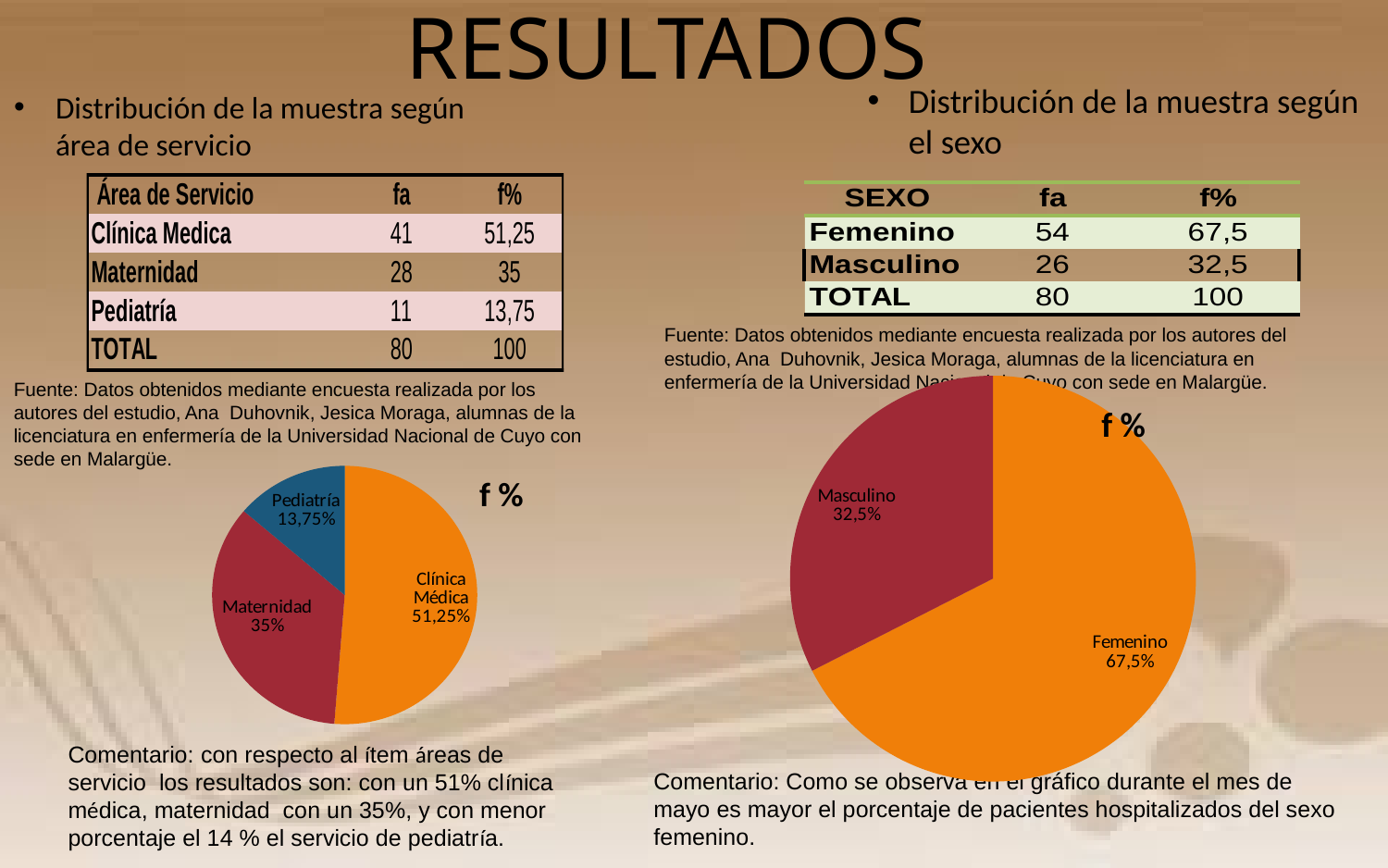
On the left pie chart, which category has the largest slice? Clínica Médica What type of chart is the right chart? Pie chart On the left pie chart, what is the value for Pediatría? 13,75% On the left pie chart, how many slices are there? 3 On the left pie chart, which category has the smallest slice? Pediatría On the left pie chart, what is the value for Maternidad? 35% On the right pie chart, what is the value for Masculino? 32,5% On the right pie chart, what is the difference between Femenino and Masculino? 35% On the right pie chart, what is the value for Femenino? 67,5% On the right pie chart, which is larger, Femenino or Masculino? Femenino On the left pie chart, what is the difference between Maternidad and Pediatría? 21,25% On the left pie chart, what is the value for Clínica Médica? 51,25%